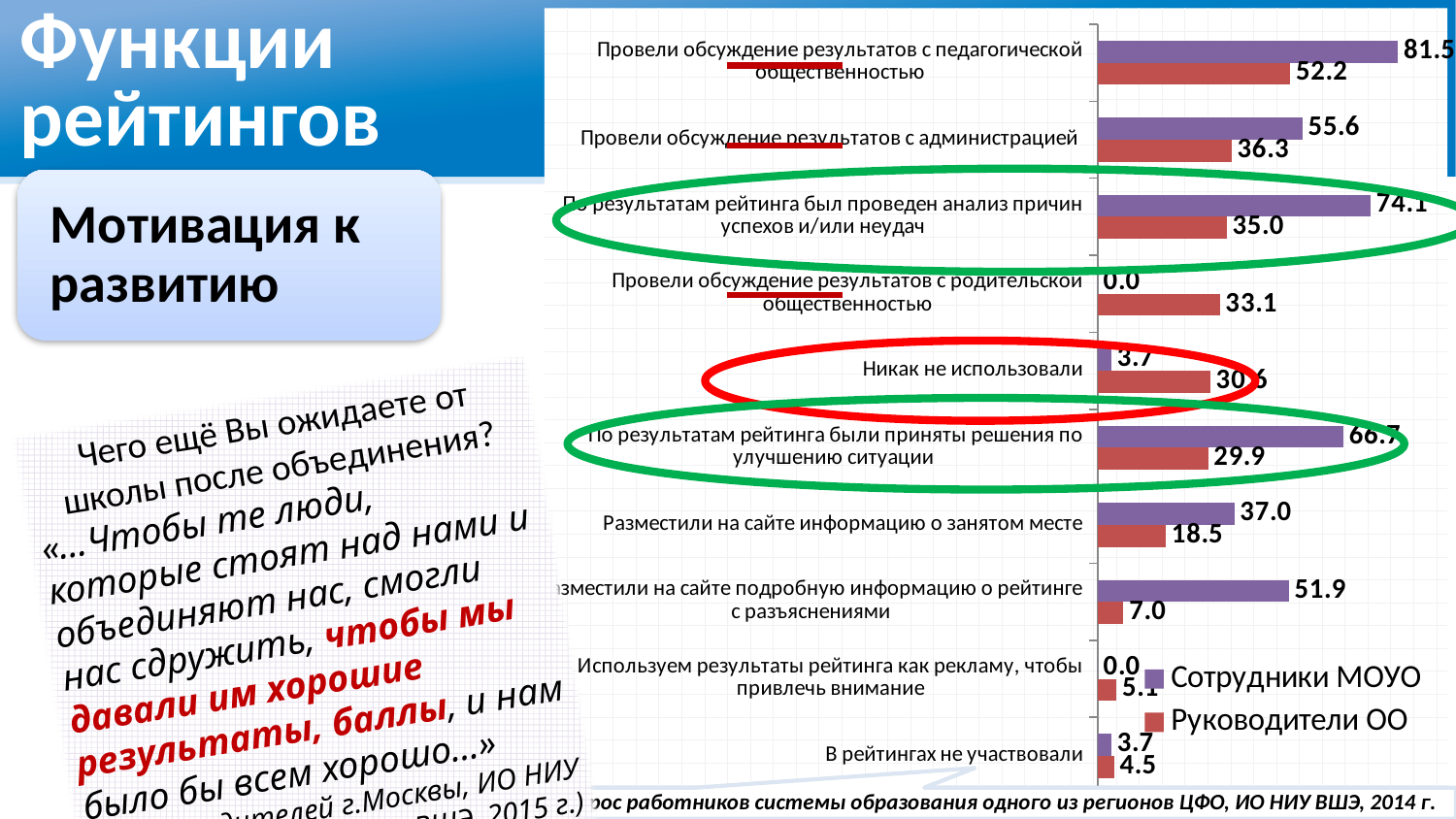
What is the difference between the Сотрудники МОУО and Руководители ОО values for "Разместили на сайте подробную информацию о рейтинге с разъяснениями"? 44.9 What value is shown for Сотрудники МОУО for "Разместили на сайте информацию о занятом месте"? 37.0 What value is shown for Руководители ОО for "Провели обсуждение результатов с родительской общественностью"? 33.1 For "Разместили на сайте подробную информацию о рейтинге с разъяснениями", which series has the larger value? Сотрудники МОУО How many series does the legend list? 2 Which category has the highest value for Сотрудники МОУО? Провели обсуждение результатов с педагогической общественностью How many categories are shown in the chart? 10 What value is shown for Руководители ОО for "Провели обсуждение результатов с администрацией"? 36.3 What is the difference between the Сотрудники МОУО and Руководители ОО values for "Провели обсуждение результатов с педагогической общественностью"? 29.3 What kind of chart is shown on the slide? Bar chart What value is shown for Сотрудники МОУО for "Провели обсуждение результатов с педагогической общественностью"? 81.5 Which category has the lowest value for Руководители ОО? В рейтингах не участвовали